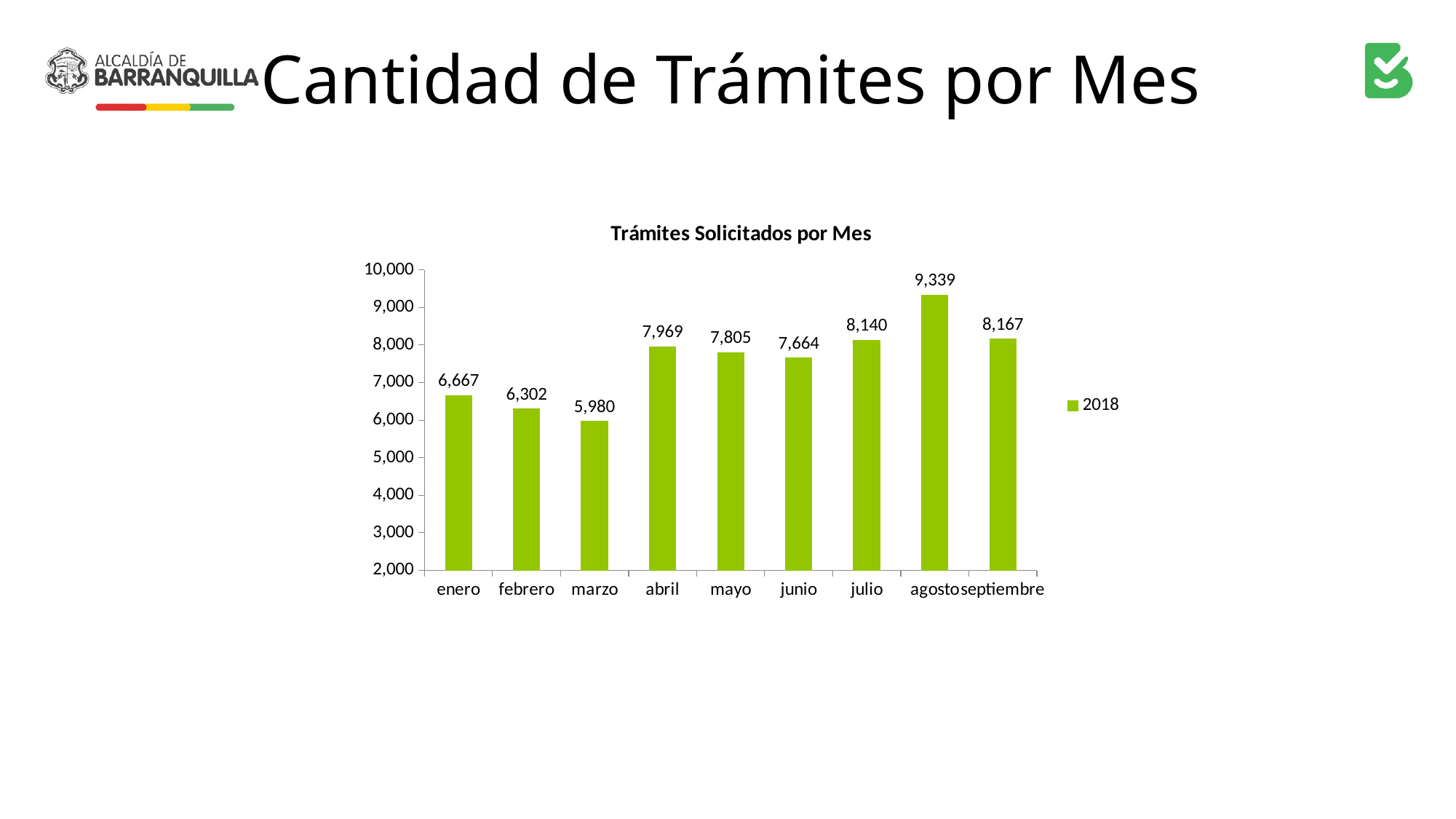
What is the difference between the values for enero and febrero? 365 What is the difference between the values for agosto and septiembre? 1,172 What is the value for abril? 7,969 Which is larger, the value for julio or the value for septiembre? septiembre How many months are shown on the x axis? 9 What is the value for agosto? 9,339 What kind of chart is shown? bar chart What is the value for marzo? 5,980 What is the title of the chart? Trámites Solicitados por Mes How many series does the legend list? 1 Which month has the lowest value? marzo Which month has the highest value? agosto